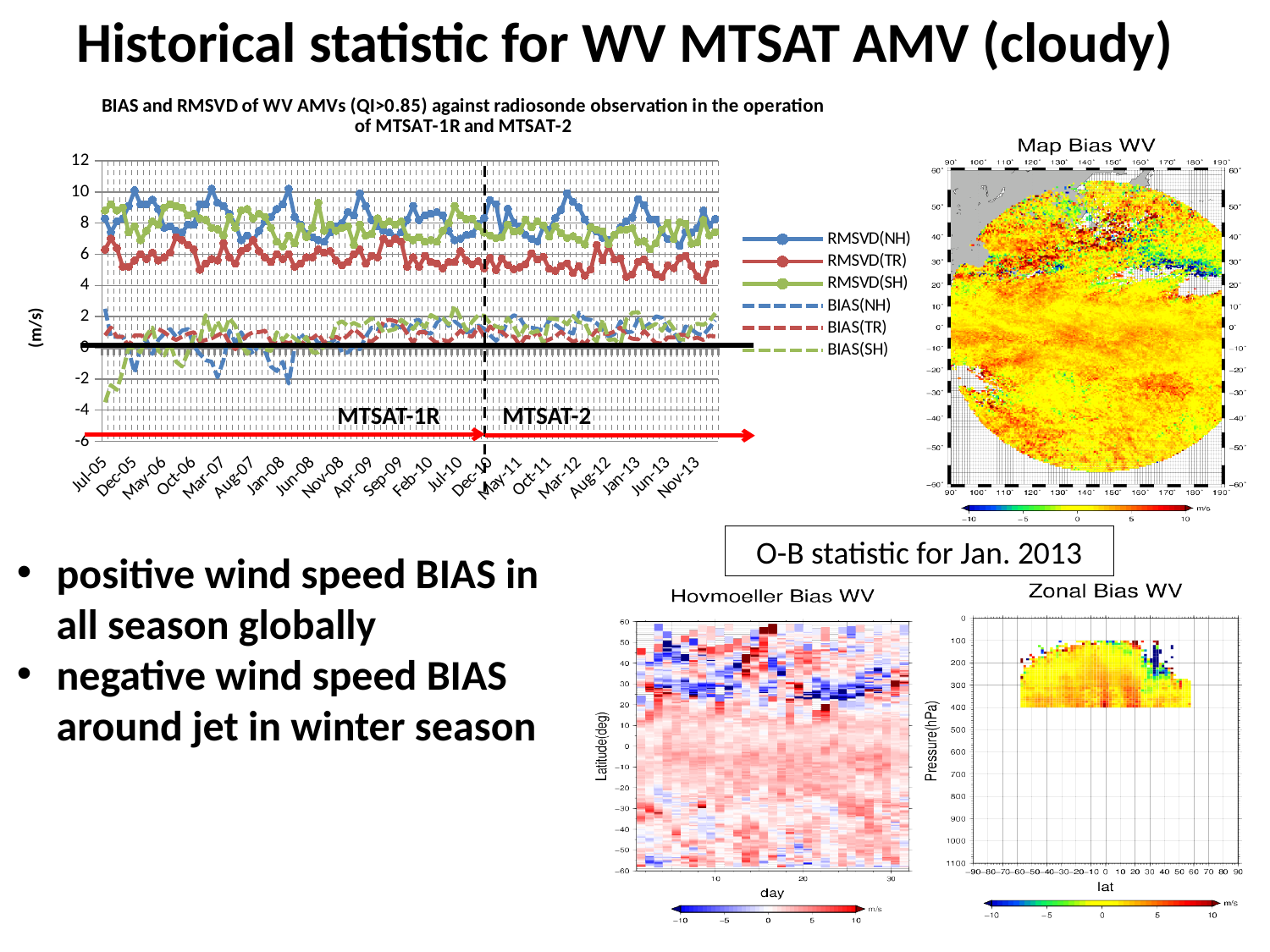
In the BIAS and RMSVD chart, is the BIAS(SH) value at Jul-05 greater or less than 0? less In the BIAS and RMSVD chart, which is larger at Nov-13: RMSVD(SH) or BIAS(SH)? RMSVD(SH) In the BIAS and RMSVD chart, which is larger at Jan-08: RMSVD(NH) or RMSVD(TR)? RMSVD(NH) In the BIAS and RMSVD chart, which of the three RMSVD series is generally the lowest? RMSVD(TR) In the BIAS and RMSVD chart, is the RMSVD(NH) value at Jan-08 greater or less than 6? greater In the BIAS and RMSVD chart, what kind of chart is used to show the time series? line chart In the BIAS and RMSVD chart, is the RMSVD(TR) value at Jul-05 greater or less than 8? less In the BIAS and RMSVD chart, which of the three RMSVD series is generally the highest? RMSVD(NH) In the BIAS and RMSVD chart, how many series does the legend list? 6 In the BIAS and RMSVD chart, what unit is shown on the y axis? (m/s) In the BIAS and RMSVD chart, which two satellite operation periods are labelled along the x axis? MTSAT-1R and MTSAT-2